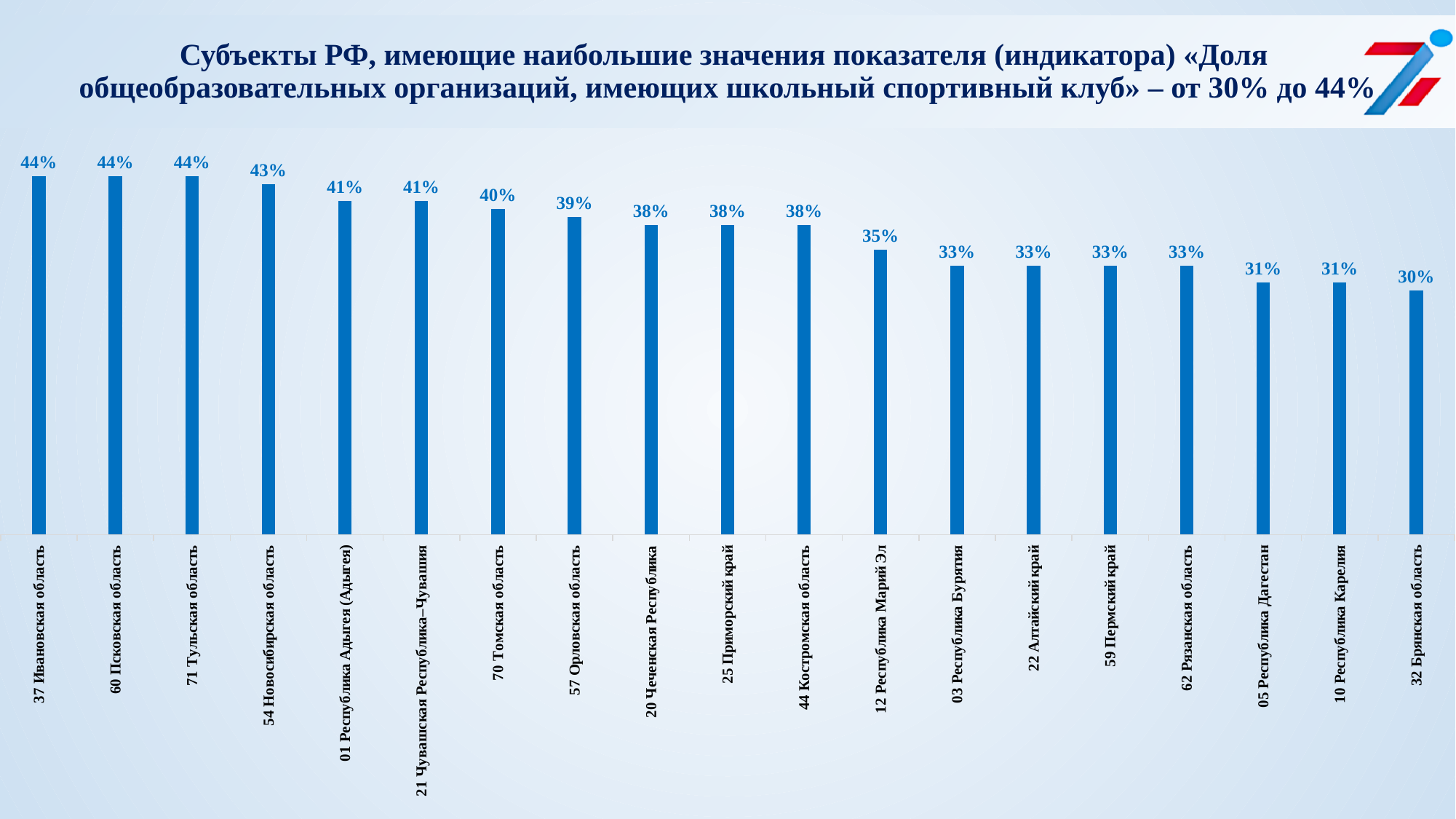
How many regions are shown on the chart? 19 What is the value for Республика Марий Эл? 35% Do the values rise or fall from left to right along the x axis? Fall What is the value for Новосибирская область? 43% What is the difference between the values for Орловская область and Республика Бурятия? 6% What kind of chart is shown on the slide? Bar chart What is the value for Республика Дагестан? 31% What is the value for Томская область? 40% What is the highest value shown on the chart? 44% Which is larger, the value for Чувашская Республика or the value for Пермский край? Чувашская Республика What is the difference between the values for Ивановская область and Брянская область? 14% Which region has the lowest value on the chart? Брянская область